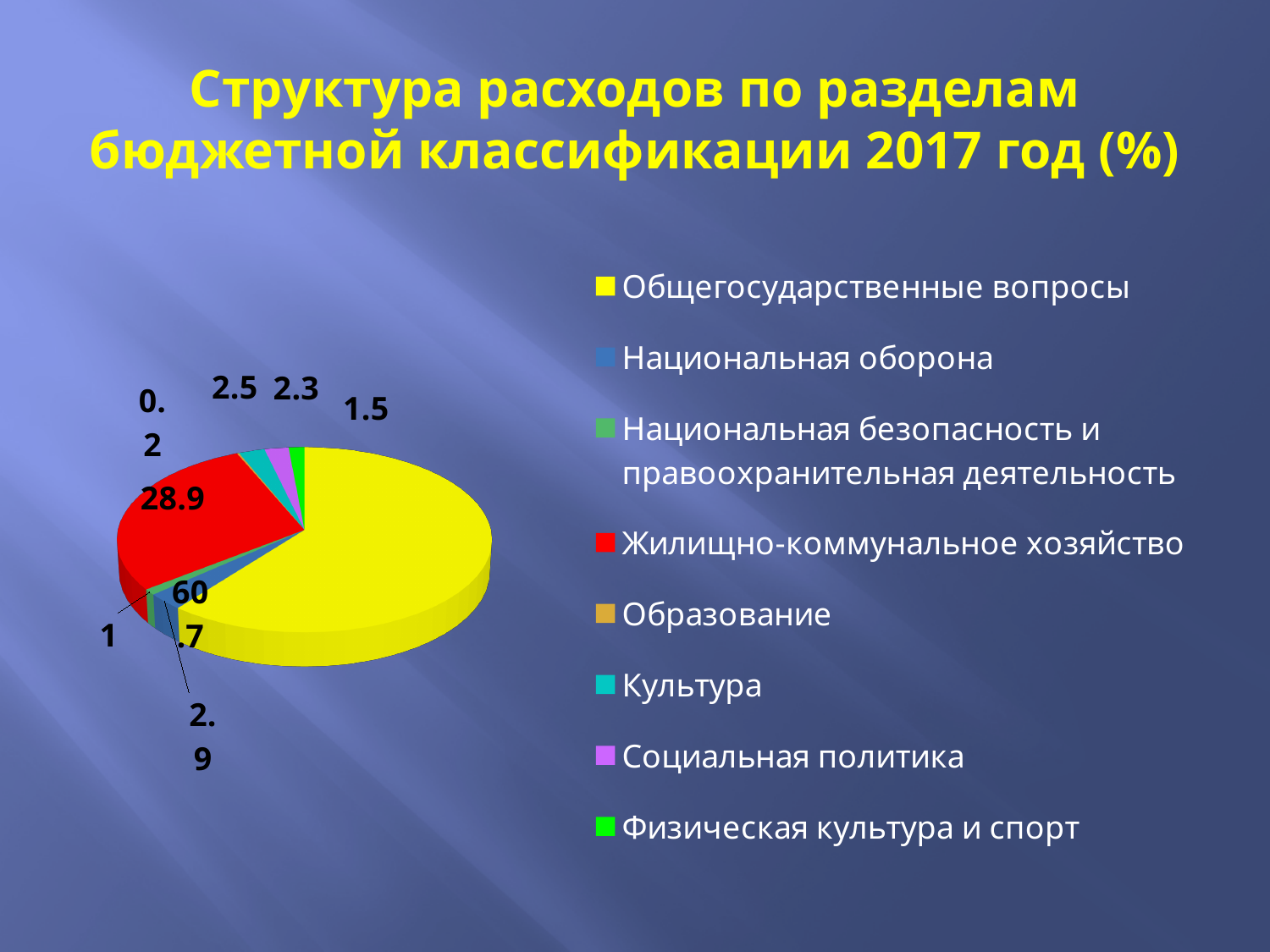
What is the value for Физическая культура и спорт? 1.5 What is the value for Культура? 2.5 How many categories does the pie chart have? 8 What is the value for Социальная политика? 2.3 What is the value for Общегосударственные вопросы? 60.7 What type of chart is shown on the slide? Pie chart Which is larger, the value for Культура or the value for Социальная политика? Культура Which category has the largest share of the pie? Общегосударственные вопросы What colour is the slice for Жилищно-коммунальное хозяйство? Red What is the value for Жилищно-коммунальное хозяйство? 28.9 Which category has the smallest share of the pie? Образование What is the difference between the values for Жилищно-коммунальное хозяйство and Культура? 26.4